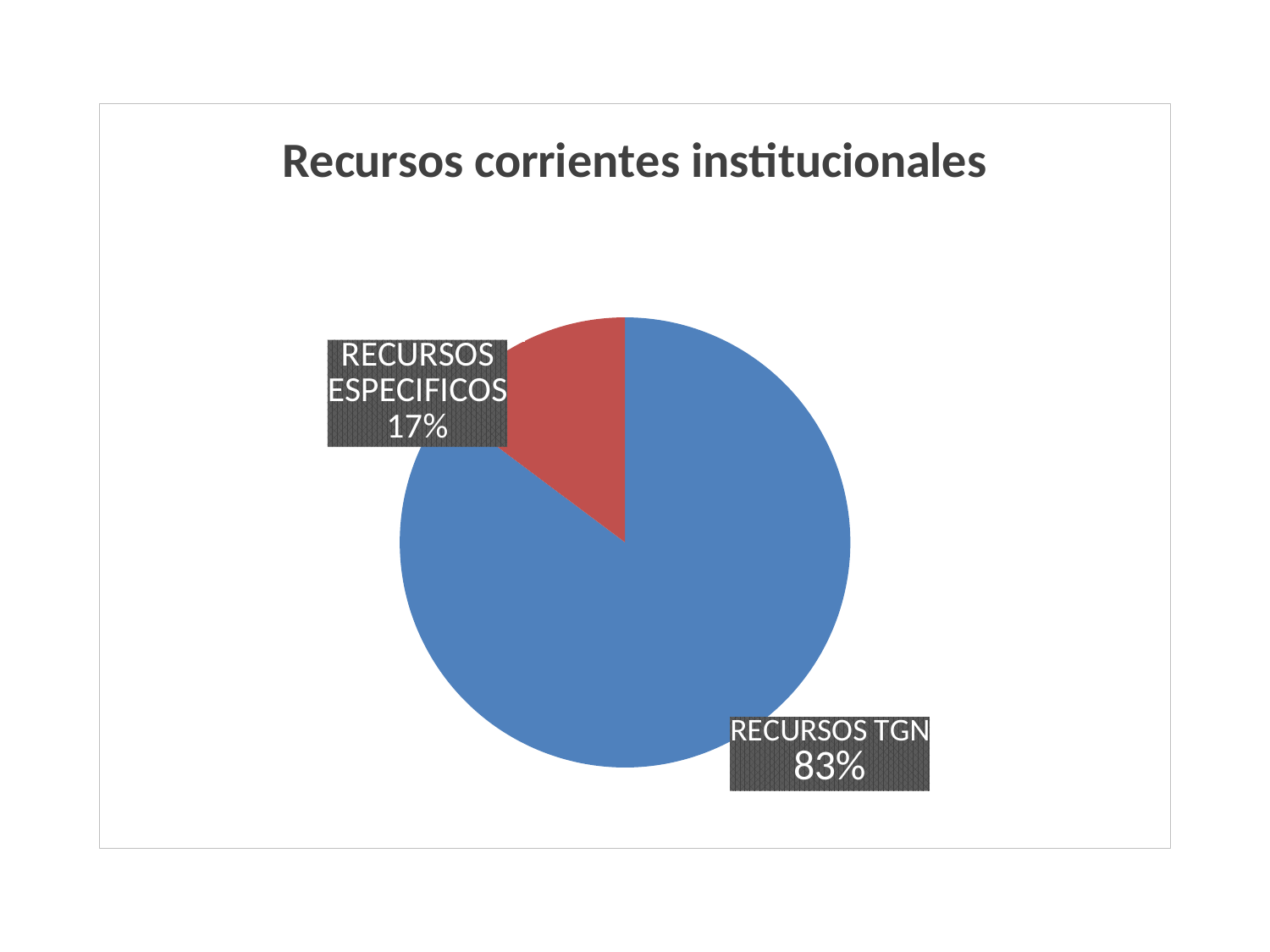
What share of the pie does RECURSOS ESPECIFICOS represent? 17% Which is larger, RECURSOS TGN or RECURSOS ESPECIFICOS? RECURSOS TGN Which category has the largest slice of the pie? RECURSOS TGN What is the title of the chart? Recursos corrientes institucionales Which category has the smallest slice of the pie? RECURSOS ESPECIFICOS What share of the pie does RECURSOS TGN represent? 83% What colour is the RECURSOS ESPECIFICOS slice? red What is the difference in percentage points between RECURSOS TGN and RECURSOS ESPECIFICOS? 66 How many slices does the pie chart have? 2 What type of chart is shown on the slide? pie chart